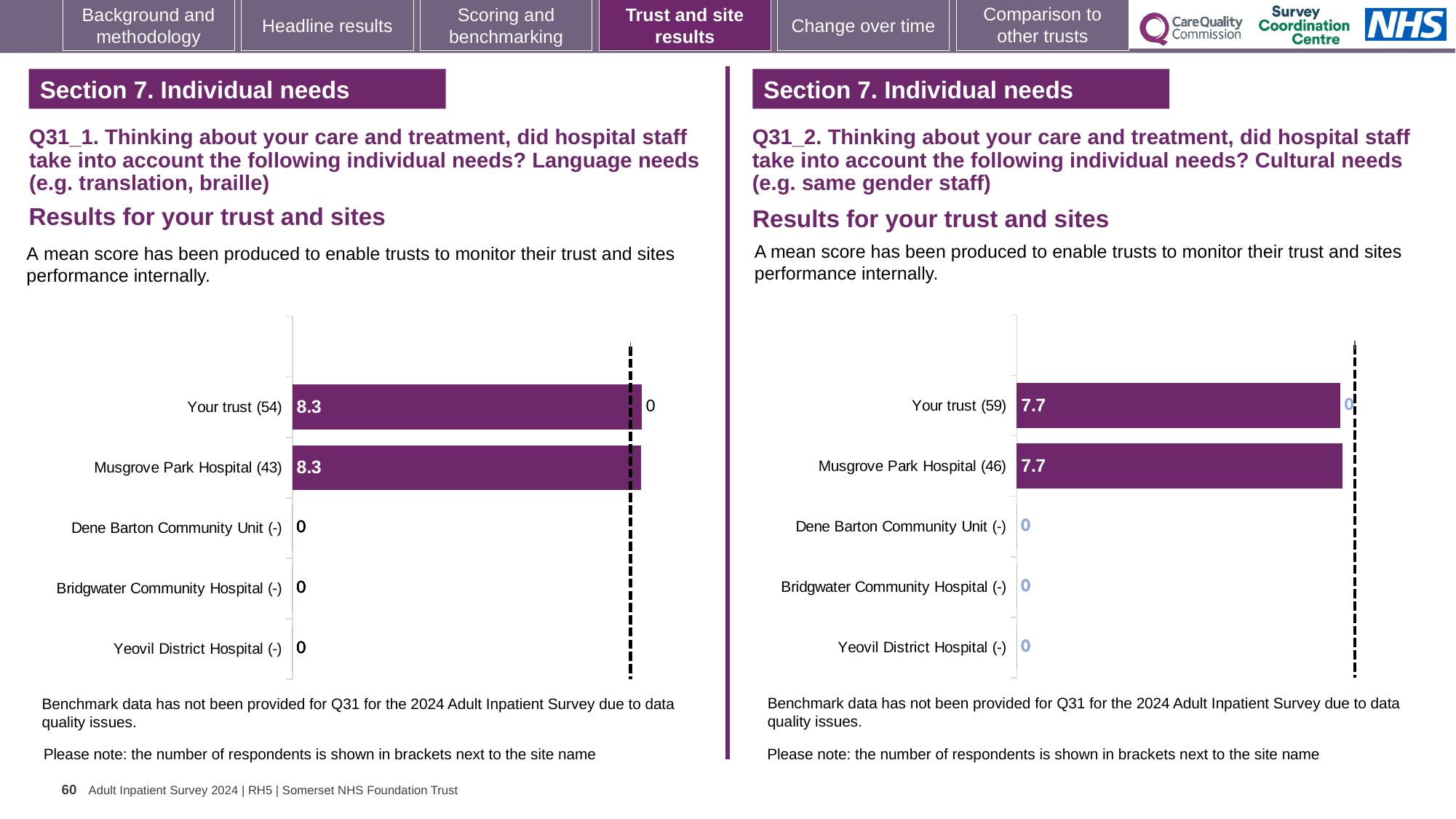
In the left chart (Q31_1, Language needs), what is the mean score for Musgrove Park Hospital? 8.3 In the left chart (Q31_1, Language needs), what value is shown for Yeovil District Hospital? 0 How many sites/categories are listed in the left chart (Q31_1, Language needs)? 5 In the right chart (Q31_2, Cultural needs), how many respondents are shown in brackets for Your trust? 59 Is the Your trust score higher in the left chart (Q31_1, Language needs) or the right chart (Q31_2, Cultural needs)? Left chart (Q31_1, Language needs) In the right chart (Q31_2, Cultural needs), what is the mean score for Your trust? 7.7 What type of chart is used in the right chart (Q31_2, Cultural needs)? Bar chart What is the difference between the Your trust score in the left chart (Q31_1) and the Your trust score in the right chart (Q31_2)? 0.6 In the left chart (Q31_1, Language needs), how many respondents are shown in brackets for Musgrove Park Hospital? 43 In the right chart (Q31_2, Cultural needs), what is the mean score for Musgrove Park Hospital? 7.7 In the left chart (Q31_1, Language needs), what is the mean score for Your trust? 8.3 How many sites/categories are listed in the right chart (Q31_2, Cultural needs)? 5